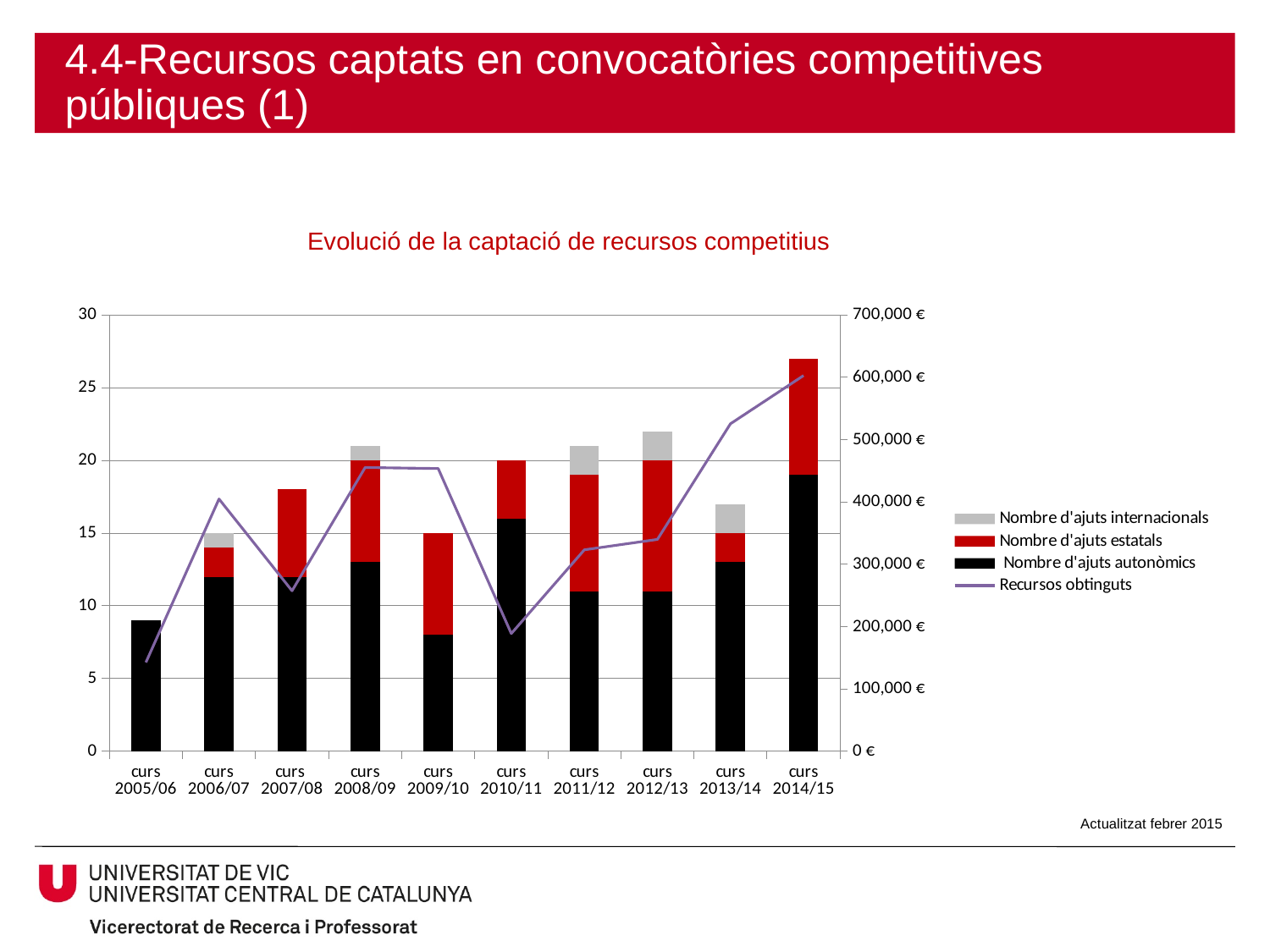
In which academic year does the Recursos obtinguts line reach its highest point? curs 2014/15 Is the total stacked bar for curs 2014/15 greater or less than 25? greater Is the Recursos obtinguts value higher in curs 2008/09 or in curs 2010/11? curs 2008/09 Which academic year has the tallest stacked bar (highest total number of ajuts)? curs 2014/15 What is the title of the chart? Evolució de la captació de recursos competitius In which academic year is the Recursos obtinguts line at its lowest point? curs 2005/06 How many series does the legend list? 4 Is the Recursos obtinguts value for curs 2014/15 greater or less than 500,000 €? greater How many academic years (curs) are shown on the x axis? 10 What type of chart is shown on the slide? Stacked bar chart with a line Is the Recursos obtinguts value for curs 2010/11 greater or less than 300,000 €? less Which academic year has the shortest stacked bar (lowest total number of ajuts)? curs 2005/06